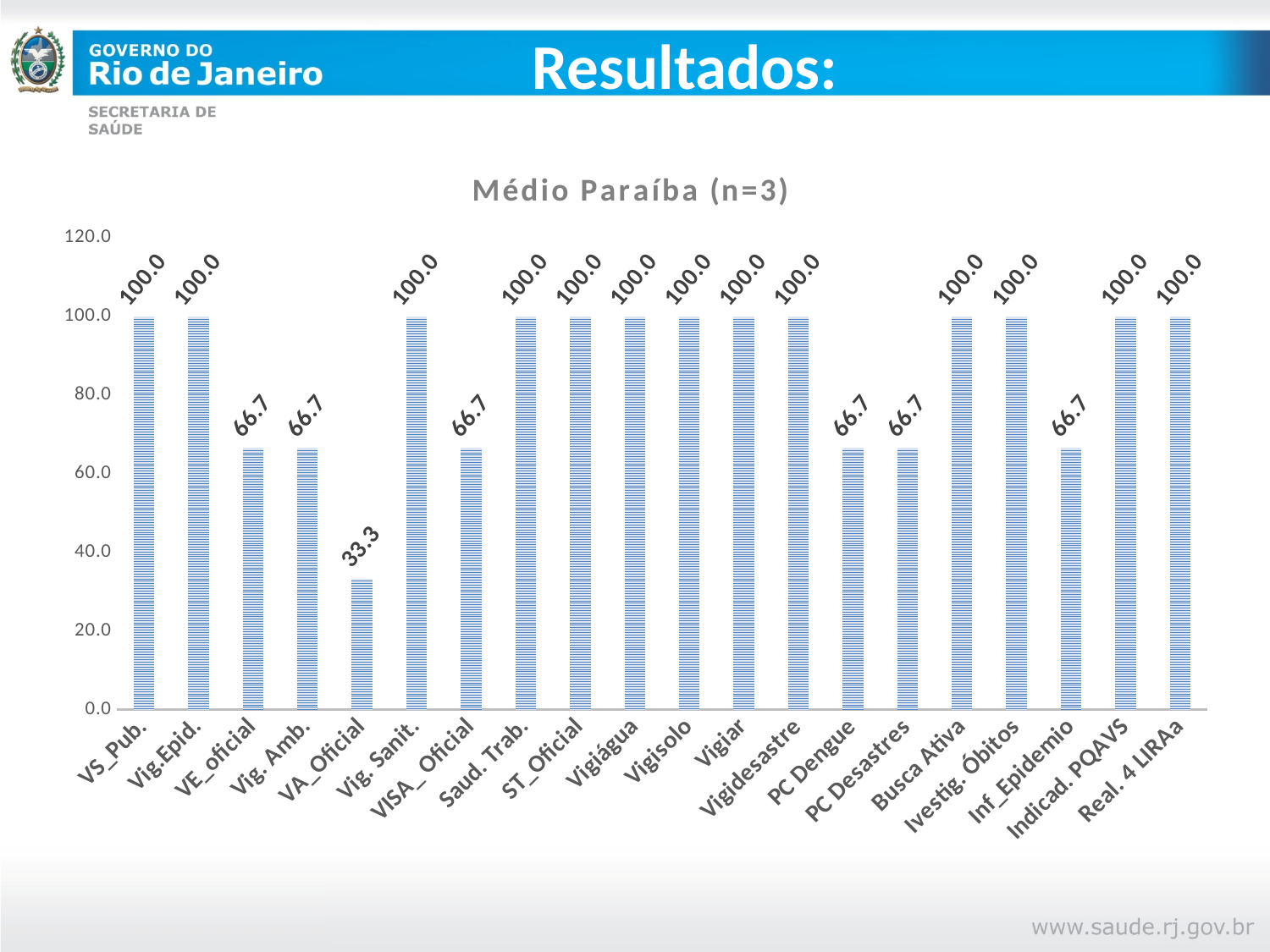
What is the value for Inf_Epidemio? 66.7 What is the value for PC Dengue? 66.7 How many categories are shown on the x axis of the chart? 20 Which category has the lowest value in the chart? VA_Oficial How many bars in the chart have a value of 66.7? 6 What is the difference between the values for VE_oficial and VA_Oficial? 33.4 What is the title of the chart? Médio Paraíba (n=3) What is the difference between the values for Vig. Sanit. and VISA_ Oficial? 33.3 What is the value for Vigiágua? 100.0 What kind of chart is shown on the slide? Bar chart Which is larger, the value for Vig. Amb. or the value for Busca Ativa? Busca Ativa What is the value for VA_Oficial in the Médio Paraíba chart? 33.3